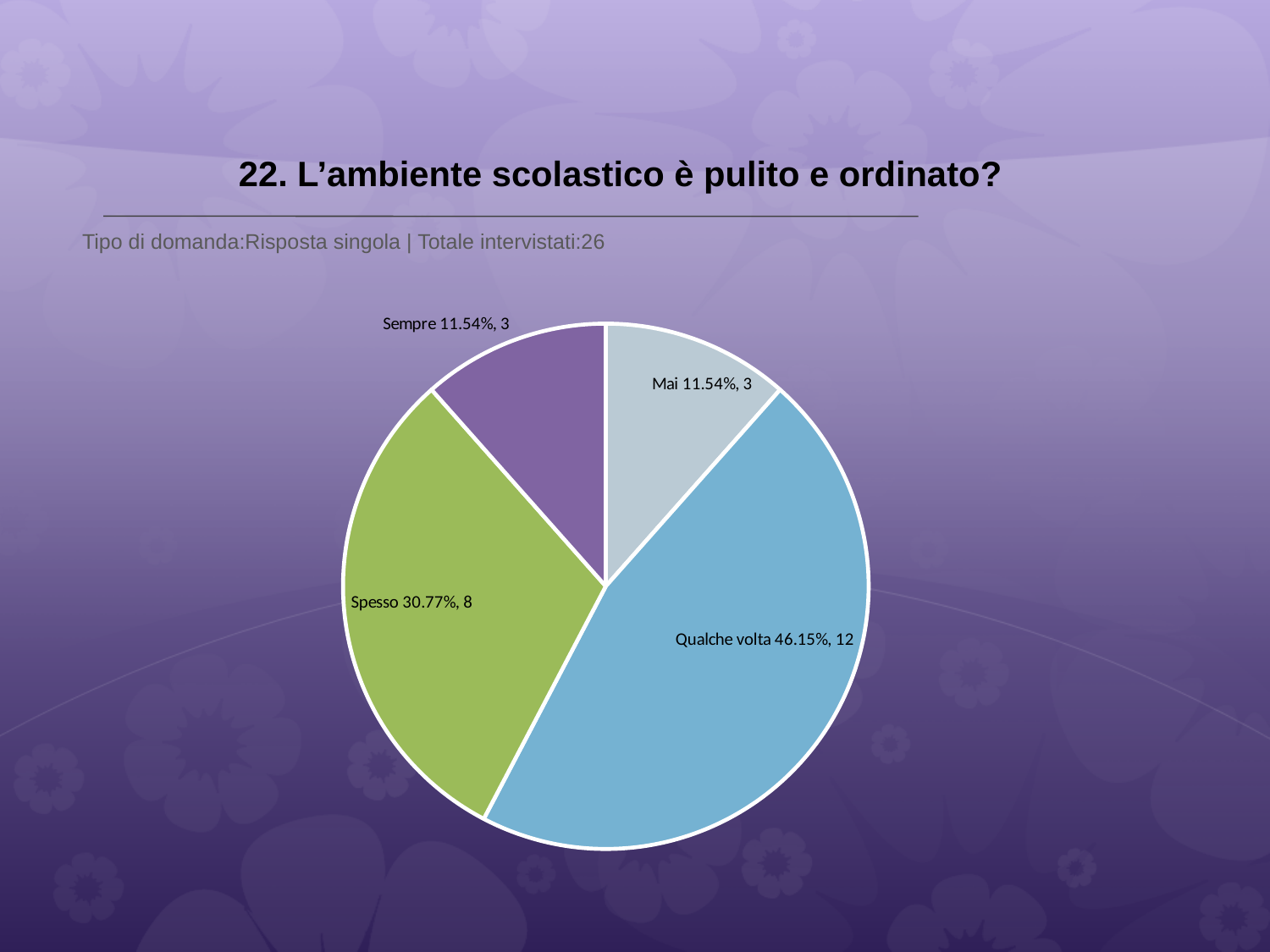
How many slices does the pie chart have? 4 What is the title of the chart on the slide? 22. L'ambiente scolastico è pulito e ordinato? Which slice is larger, 'Spesso' or 'Sempre'? Spesso What is the difference in respondent count between 'Qualche volta' and 'Spesso'? 4 How many respondents answered 'Mai'? 3 Which category has the largest slice of the pie? Qualche volta What colour is the 'Spesso' slice? green How many respondents answered 'Spesso'? 8 What percentage share does the 'Qualche volta' slice have? 46.15% What is the total number of respondents across all slices? 26 What kind of chart is shown on the slide? pie chart What percentage share does the 'Sempre' slice have? 11.54%